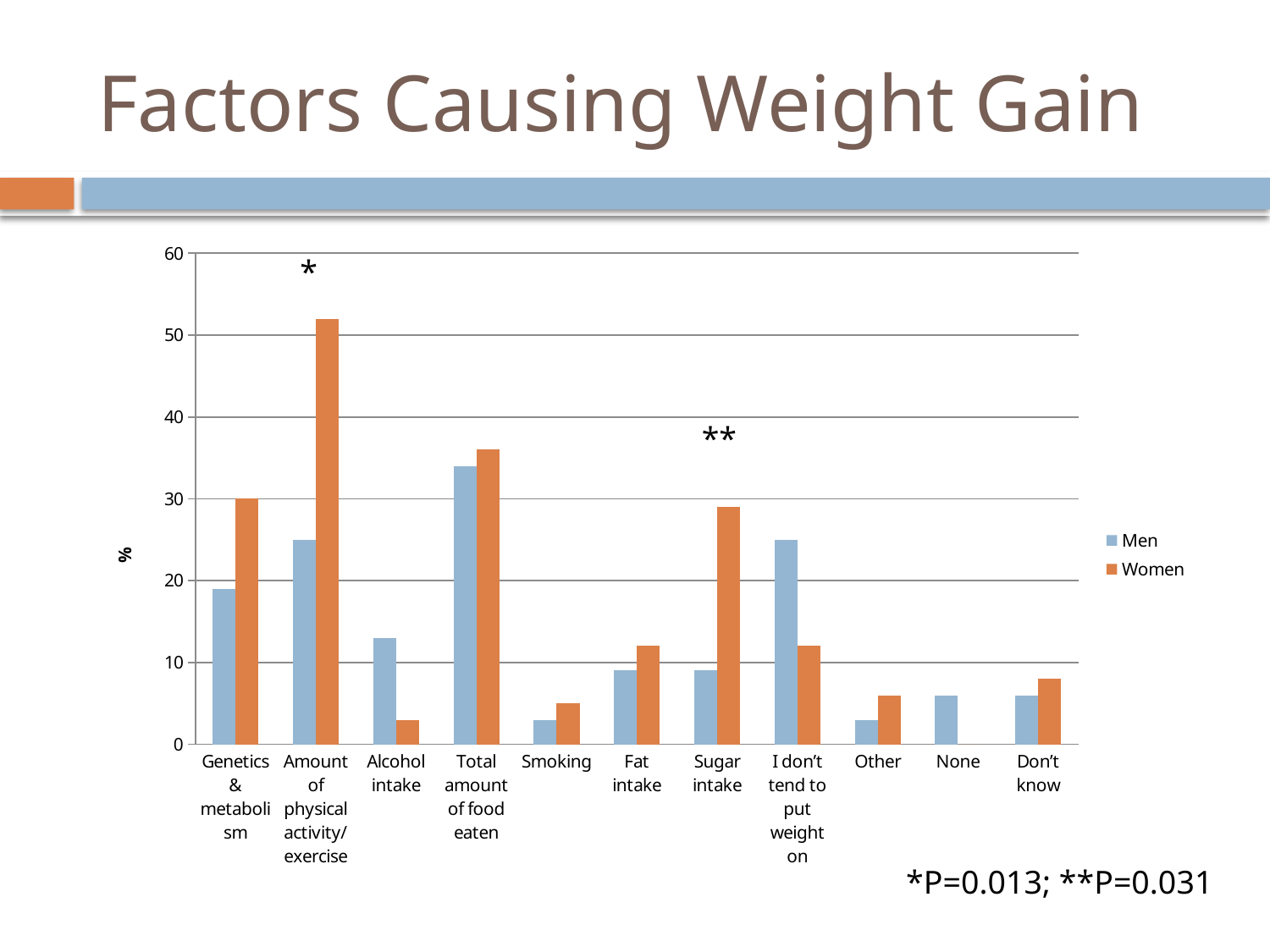
Which category has the highest value for Women? Amount of physical activity/exercise Which category has the highest value for Men? Total amount of food eaten Is the value for Women for Amount of physical activity/exercise greater or less than 50? greater Is the value for Men for Genetics & metabolism greater or less than 20? less Which is larger for Sugar intake, the value for Men or the value for Women? Women What kind of chart is shown on the slide? bar chart How many categories are shown on the x axis? 11 What is the title of the slide containing the chart? Factors Causing Weight Gain How many series does the legend list? 2 Which is larger for I don't tend to put weight on, the value for Men or the value for Women? Men Which category has no visible bar for Women? None Is the value for Women for Sugar intake greater or less than 20? greater